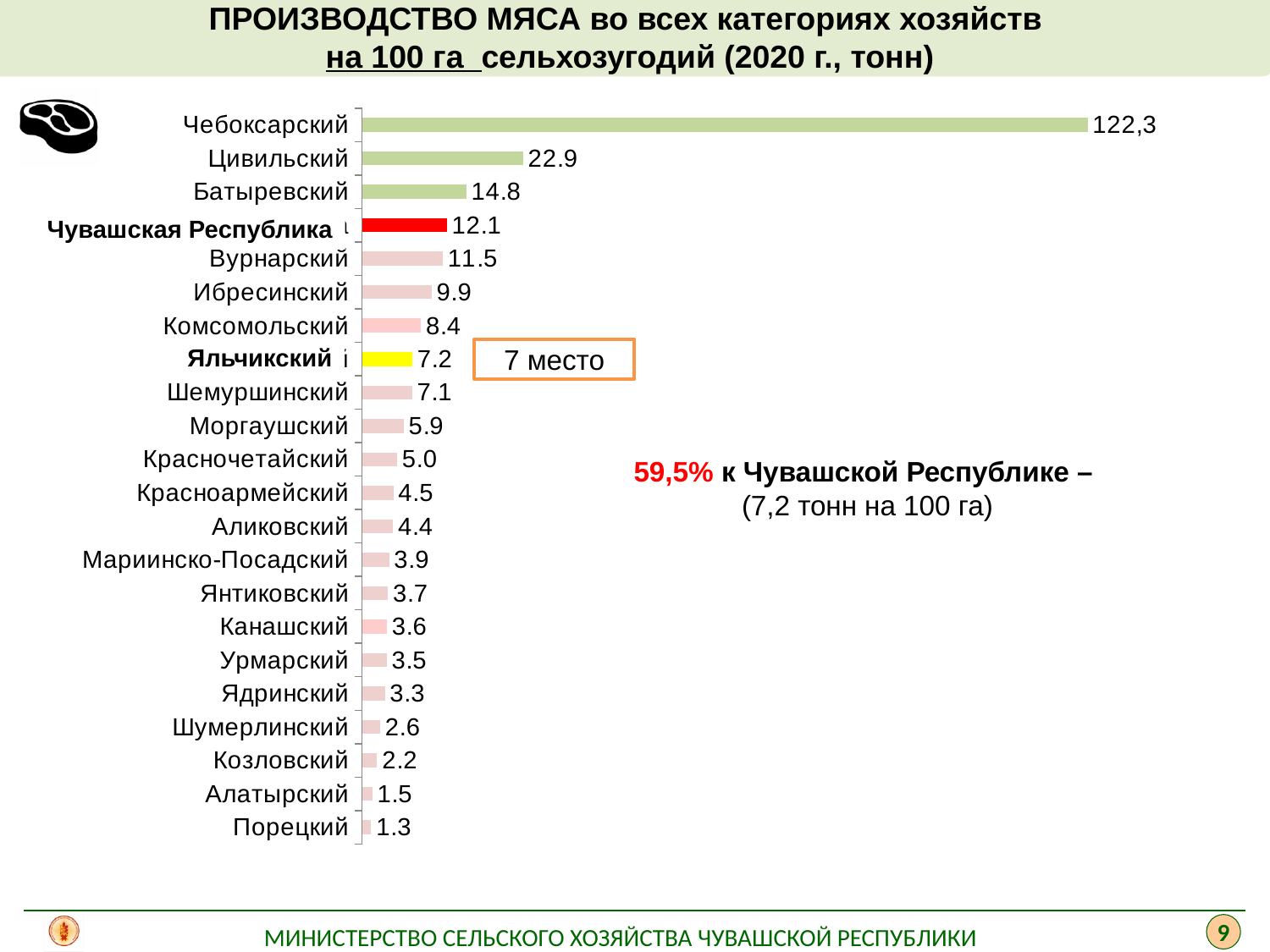
What is the value for Яльчикский? 7.2 Which category has the lowest value? Порецкий What rank is shown in the box next to the Яльчикский bar? 7 место What is the value for Чебоксарский? 122,3 Which category has the highest value? Чебоксарский What kind of chart is shown on the slide? Bar chart What is the value for Порецкий? 1.3 Which is larger, the value for Вурнарский or the value for Ибресинский? Вурнарский What is the difference between the values for Цивильский and Батыревский? 8.1 What is the value for Чувашская Республика? 12.1 How many categories are shown in the chart? 22 What is the difference between the values for Чувашская Республика and Яльчикский? 4.9